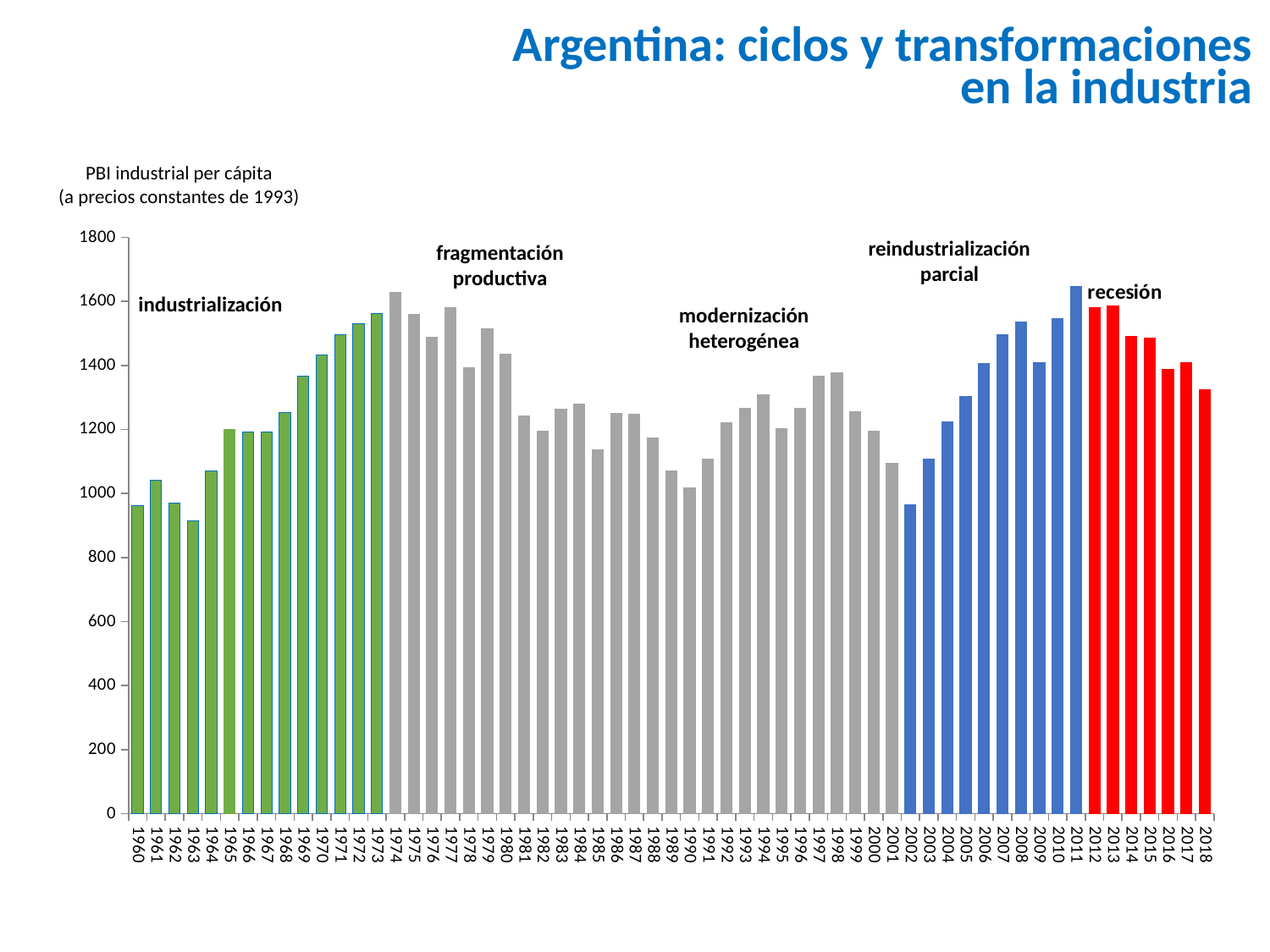
Which year has the larger value, 2002 or 2011? 2011 How many years (bars) are plotted in the chart? 59 What is the title of the chart? PBI industrial per cápita (a precios constantes de 1993) Is the value for 2018 greater or less than 1200? greater Which year has the lowest value in the chart? 1963 Is the value for 1974 greater or less than 1600? greater Which year has the larger value, 1960 or 1974? 1974 What kind of chart is shown on the slide? bar chart Do the values rise or fall from 2011 to 2018? fall What colour are the bars for the years 2012 to 2018, labelled 'recesión'? red Is the value for 2002 greater or less than 1000? less